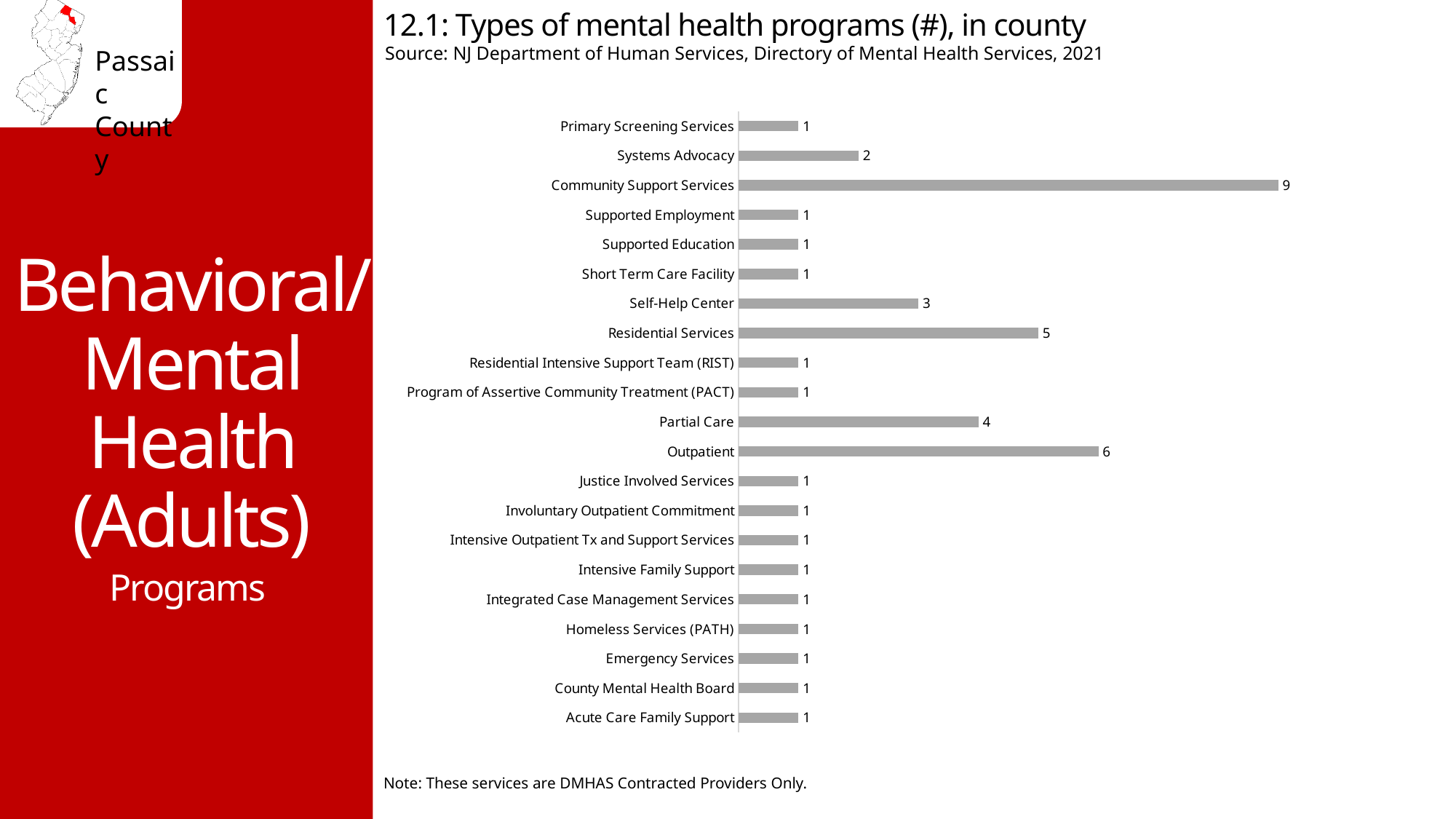
How many Outpatient programs are shown on the chart? 6 Which type of mental health program has the highest count? Community Support Services What is the value for Systems Advocacy? 2 What is the source cited for the chart? NJ Department of Human Services, Directory of Mental Health Services, 2021 What is the value for Residential Services? 5 What is the value for Partial Care? 4 What is the value for Self-Help Center? 3 What kind of chart is used to show the types of mental health programs? Bar chart Which has more programs, Residential Services or Partial Care? Residential Services What is the difference between the number of Community Support Services programs and Outpatient programs? 3 What is the number of Community Support Services programs in the county? 9 How many program types are listed on the chart? 21